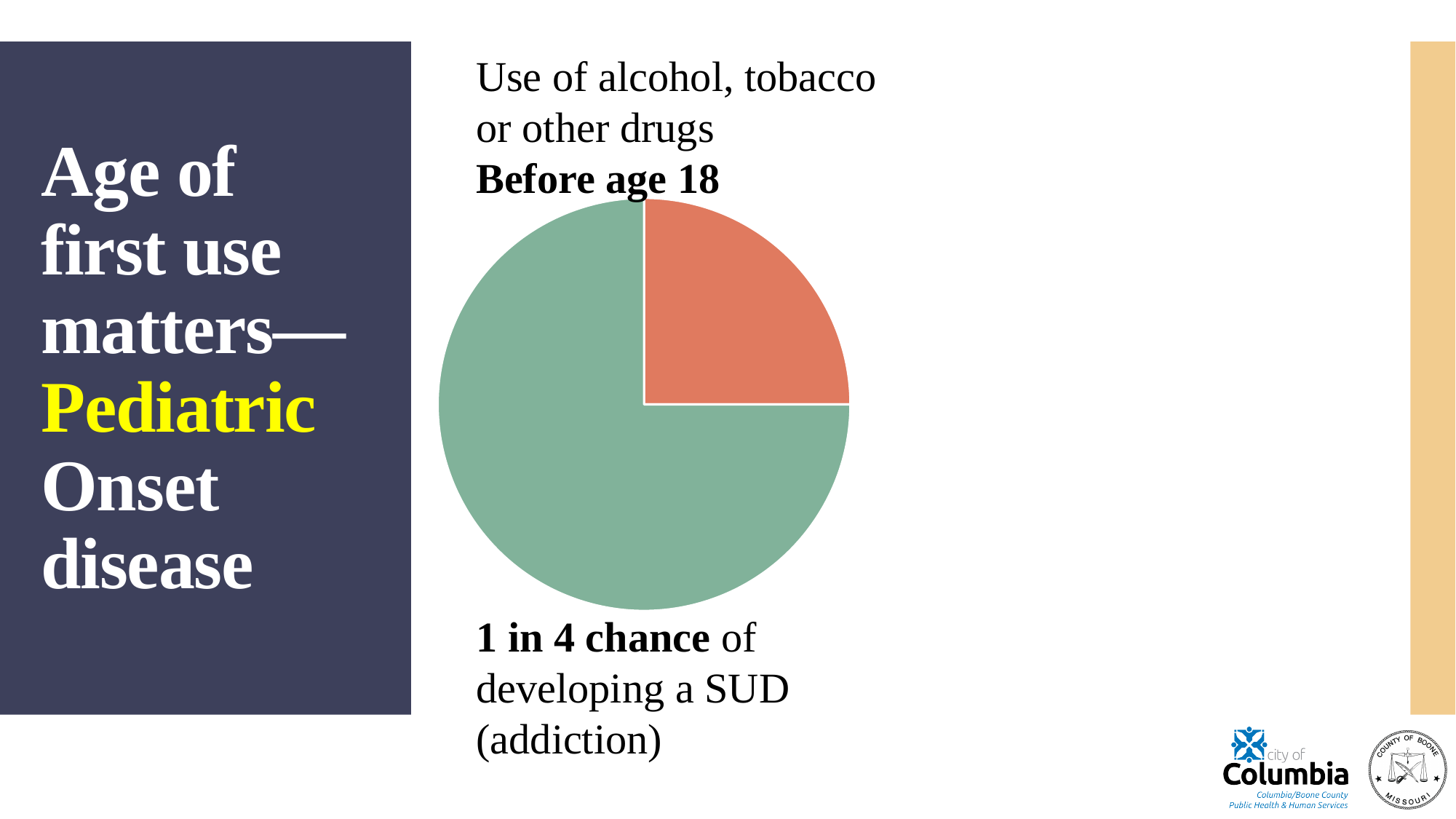
Which colour slice takes up the smallest share of the pie chart? orange What outcome does the text below the pie chart say there is a 1 in 4 chance of? developing a SUD (addiction) According to the text below the pie chart, what chance does the orange slice represent? 1 in 4 chance What age threshold is stated in the bold text above the pie chart? Before age 18 Which slice of the pie chart is larger, the green one or the orange one? the green one What kind of chart is shown on the slide? pie chart Which colour slice takes up the largest share of the pie chart? green How many slices does the pie chart have? 2